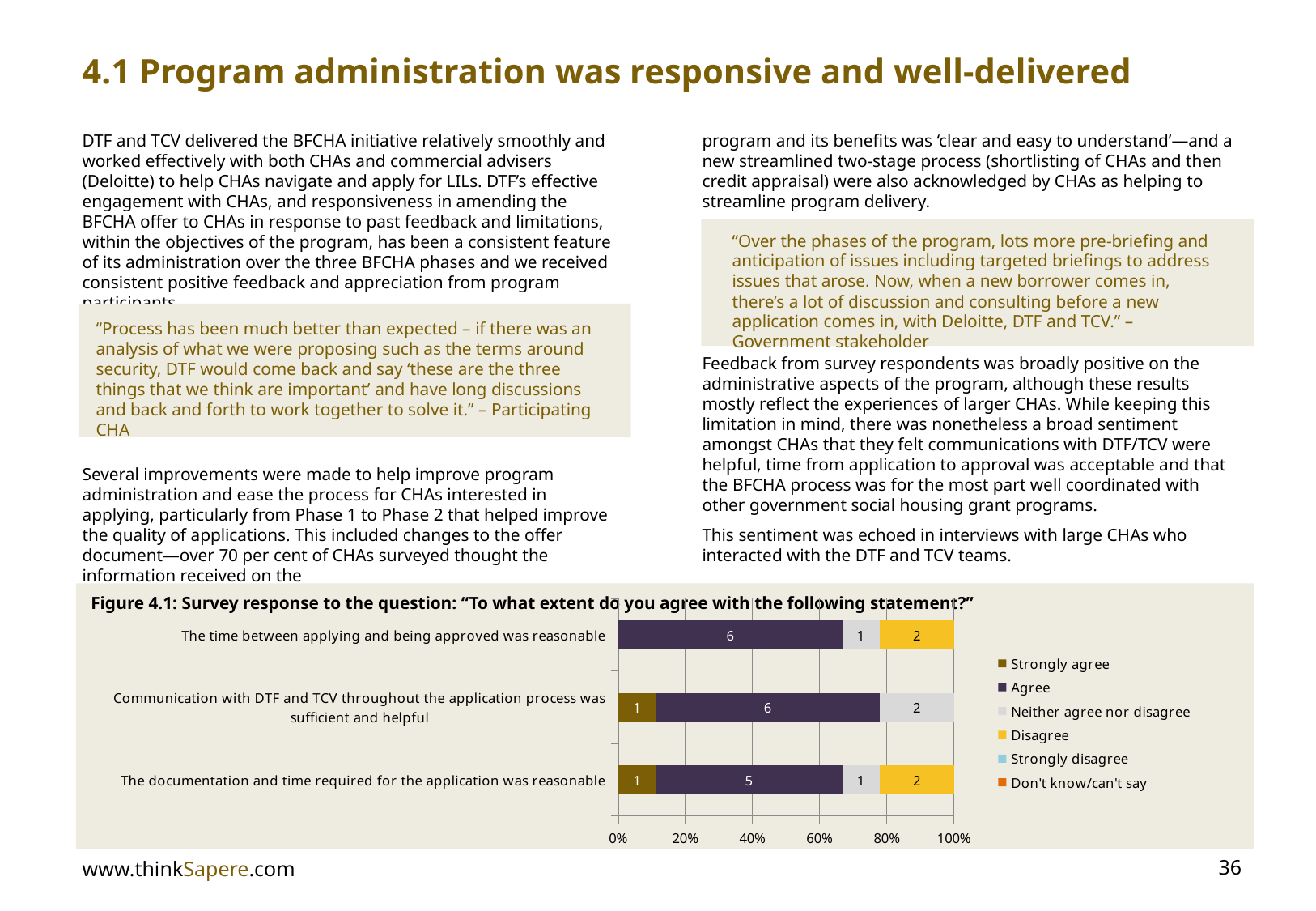
In Figure 4.1, which legend entry is shown in yellow? Disagree In Figure 4.1, what is the total number of responses shown for 'The documentation and time required for the application was reasonable'? 9 In Figure 4.1, which is larger for 'The time between applying and being approved was reasonable': the 'Neither agree nor disagree' count or the 'Disagree' count? Disagree In Figure 4.1, which statement has the lowest 'Agree' count? The documentation and time required for the application was reasonable In Figure 4.1, what is the difference between the 'Agree' counts for 'The time between applying and being approved was reasonable' and 'The documentation and time required for the application was reasonable'? 1 In Figure 4.1, how many respondents answered 'Neither agree nor disagree' for 'Communication with DTF and TCV throughout the application process was sufficient and helpful'? 2 In Figure 4.1, how many respondents answered 'Disagree' for 'The documentation and time required for the application was reasonable'? 2 How many series does the legend of Figure 4.1 list? 6 What kind of chart is shown in Figure 4.1? Stacked bar chart In Figure 4.1, how many respondents answered 'Strongly agree' for 'The documentation and time required for the application was reasonable'? 1 How many statements (categories) are plotted in Figure 4.1? 3 In Figure 4.1, how many respondents answered 'Agree' for 'The time between applying and being approved was reasonable'? 6